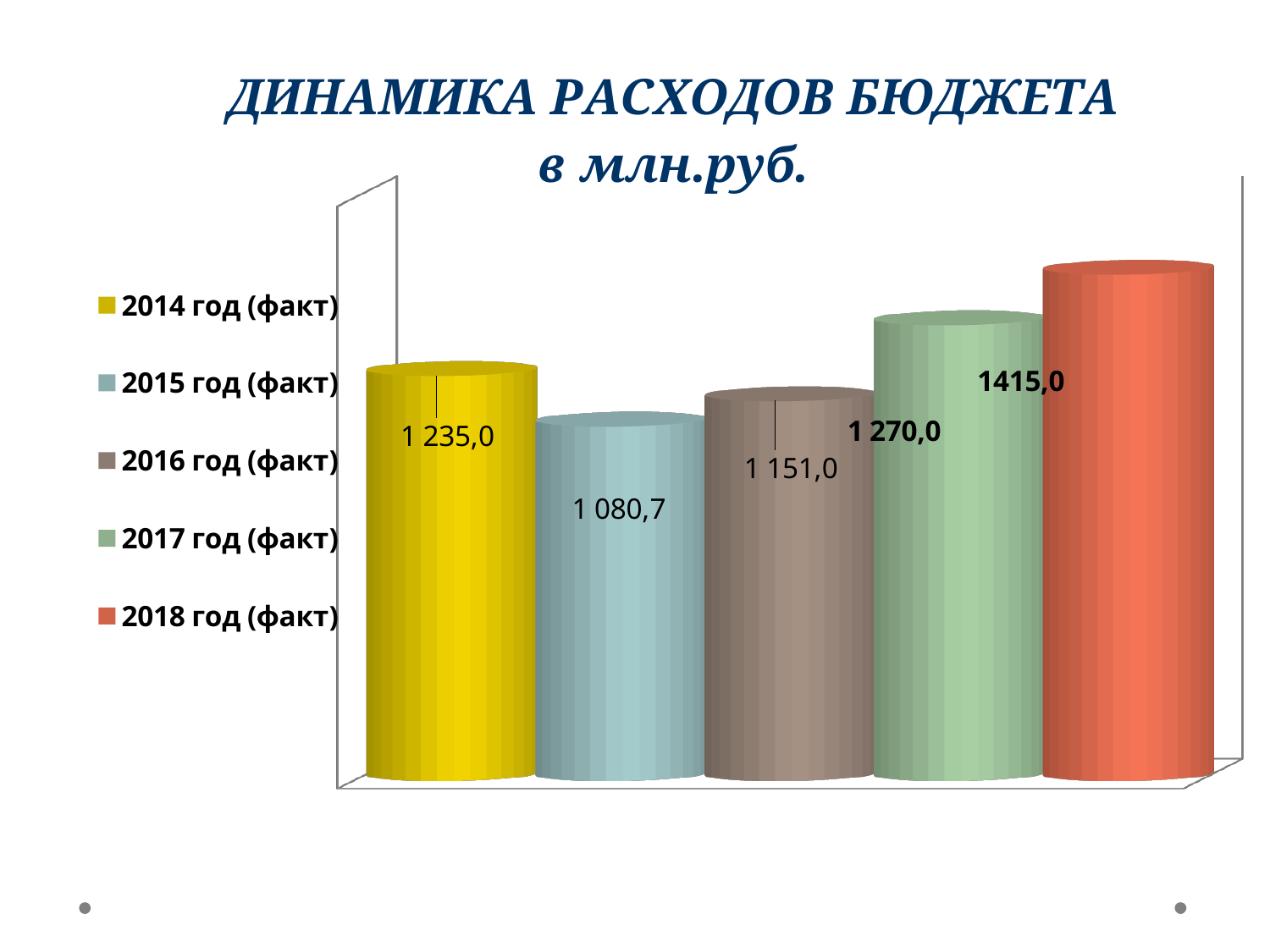
What kind of chart is shown on the slide? Bar chart What is the value for 2017 год (факт)? 1 270,0 Which year has the highest budget expenditure? 2018 год (факт) What is the difference between the values for 2014 год (факт) and 2015 год (факт)? 154,3 What is the value for 2015 год (факт)? 1 080,7 What is the value for 2014 год (факт)? 1 235,0 Which year has the lowest budget expenditure? 2015 год (факт) How many series does the legend list? 5 What is the difference between the values for 2018 год (факт) and 2017 год (факт)? 145,0 What is the value for 2018 год (факт)? 1415,0 What is the value for 2016 год (факт)? 1 151,0 Which is larger, the value for 2016 год (факт) or 2014 год (факт)? 2014 год (факт)